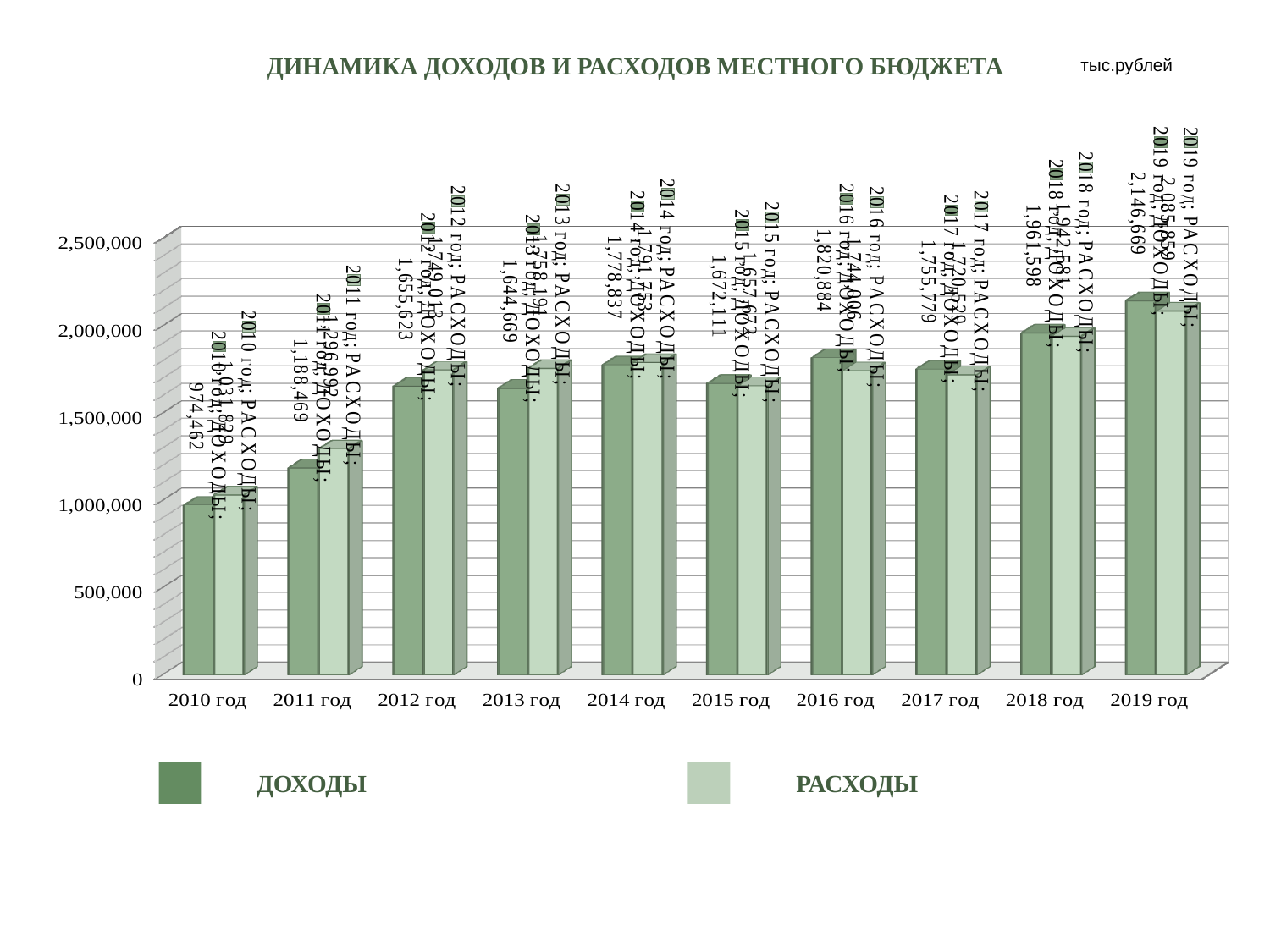
What is the value of ДОХОДЫ for 2016 год? 1,820,884 What kind of chart is shown on the slide? Bar chart What is the difference between ДОХОДЫ in 2019 год and ДОХОДЫ in 2010 год? 1,172,207 In 2010 год, which is larger: ДОХОДЫ or РАСХОДЫ? РАСХОДЫ How many series does the legend list? 2 What is the value of ДОХОДЫ for 2019 год? 2,146,669 What is the value of ДОХОДЫ for 2010 год? 974,462 How many years are shown on the x axis? 10 In which year is ДОХОДЫ the lowest? 2010 год Is the value of ДОХОДЫ for 2010 год greater or less than 1,000,000? less What unit is stated for the values in the chart? тыс.рублей In which year is ДОХОДЫ the highest? 2019 год